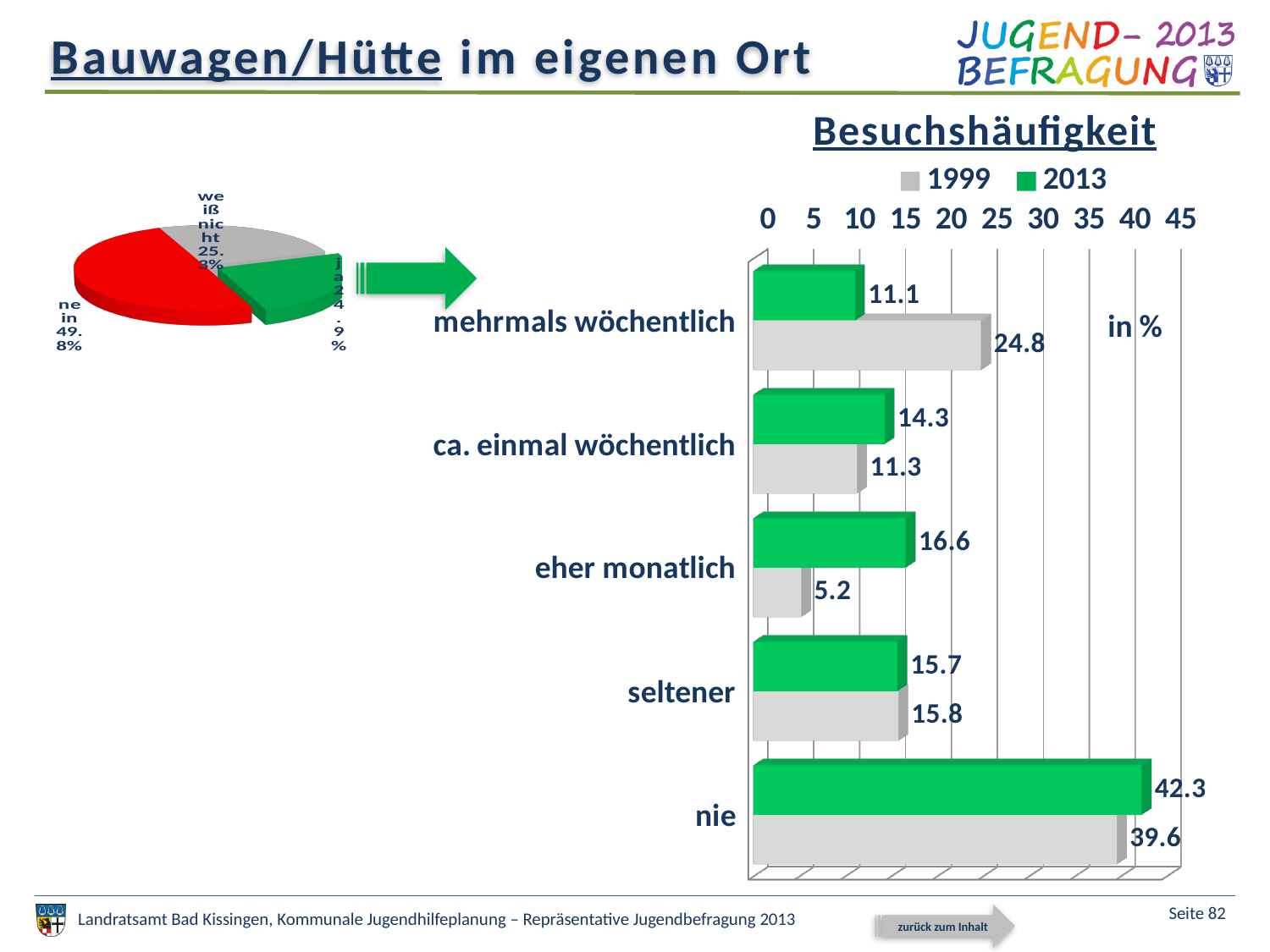
In the Besuchshäufigkeit bar chart, what is the 1999 value for 'mehrmals wöchentlich'? 24.8 In the pie chart on the left, what is the share for 'nein'? 49.8% In the Besuchshäufigkeit bar chart, which category has the highest 2013 value? nie In the Besuchshäufigkeit bar chart, which category has the lowest 1999 value? eher monatlich In the Besuchshäufigkeit bar chart, what is the 2013 value for 'ca. einmal wöchentlich'? 14.3 How many categories does the Besuchshäufigkeit bar chart show? 5 In the Besuchshäufigkeit bar chart, is the 2013 value for 'eher monatlich' larger or smaller than the 1999 value? larger In the Besuchshäufigkeit bar chart, what is the 2013 value for 'nie'? 42.3 In the Besuchshäufigkeit bar chart, what is the difference between the 1999 and 2013 values for 'mehrmals wöchentlich'? 13.7 In the Besuchshäufigkeit bar chart, what is the 1999 value for 'eher monatlich'? 5.2 How many series does the legend of the Besuchshäufigkeit chart list? 2 What kind of chart is the chart on the left of the slide? pie chart